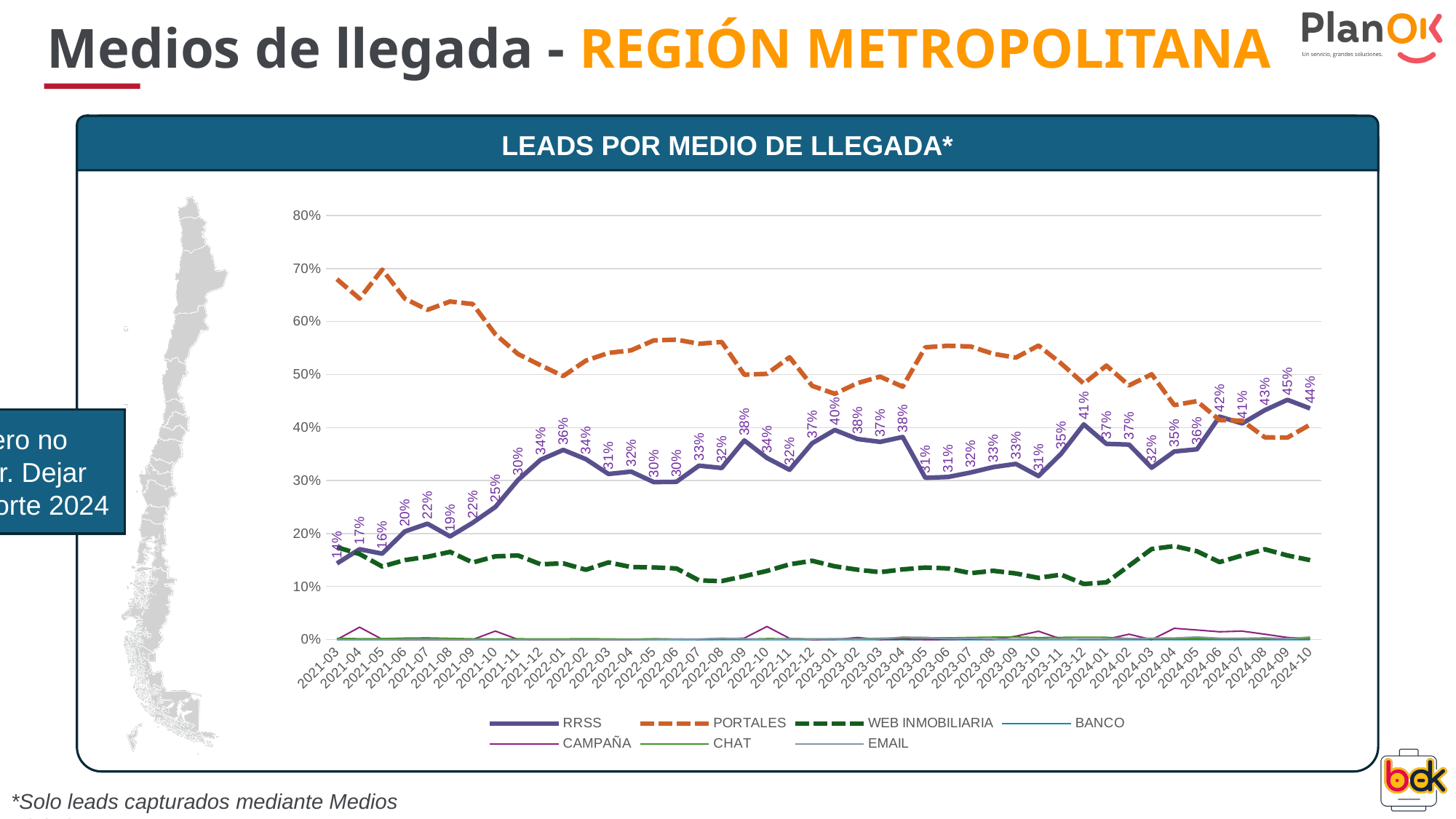
How many months are shown on the x axis? 44 Which is larger, the RRSS value in 2023-12 or in 2024-01? 2023-12 What is the RRSS value for 2021-03? 14% What is the RRSS value for 2023-01? 40% Is the PORTALES value for 2021-05 greater or less than 60%? greater What kind of chart is shown on the slide? line chart How many series does the legend list? 7 In which month does the RRSS series reach its highest labelled value? 2024-09 What is the difference between the RRSS value in 2024-09 and in 2021-03? 31% Overall, does the RRSS series rise or fall from 2021-03 to 2024-10? rise In which month does the RRSS series have its lowest labelled value? 2021-03 What is the RRSS value for 2024-10? 44%